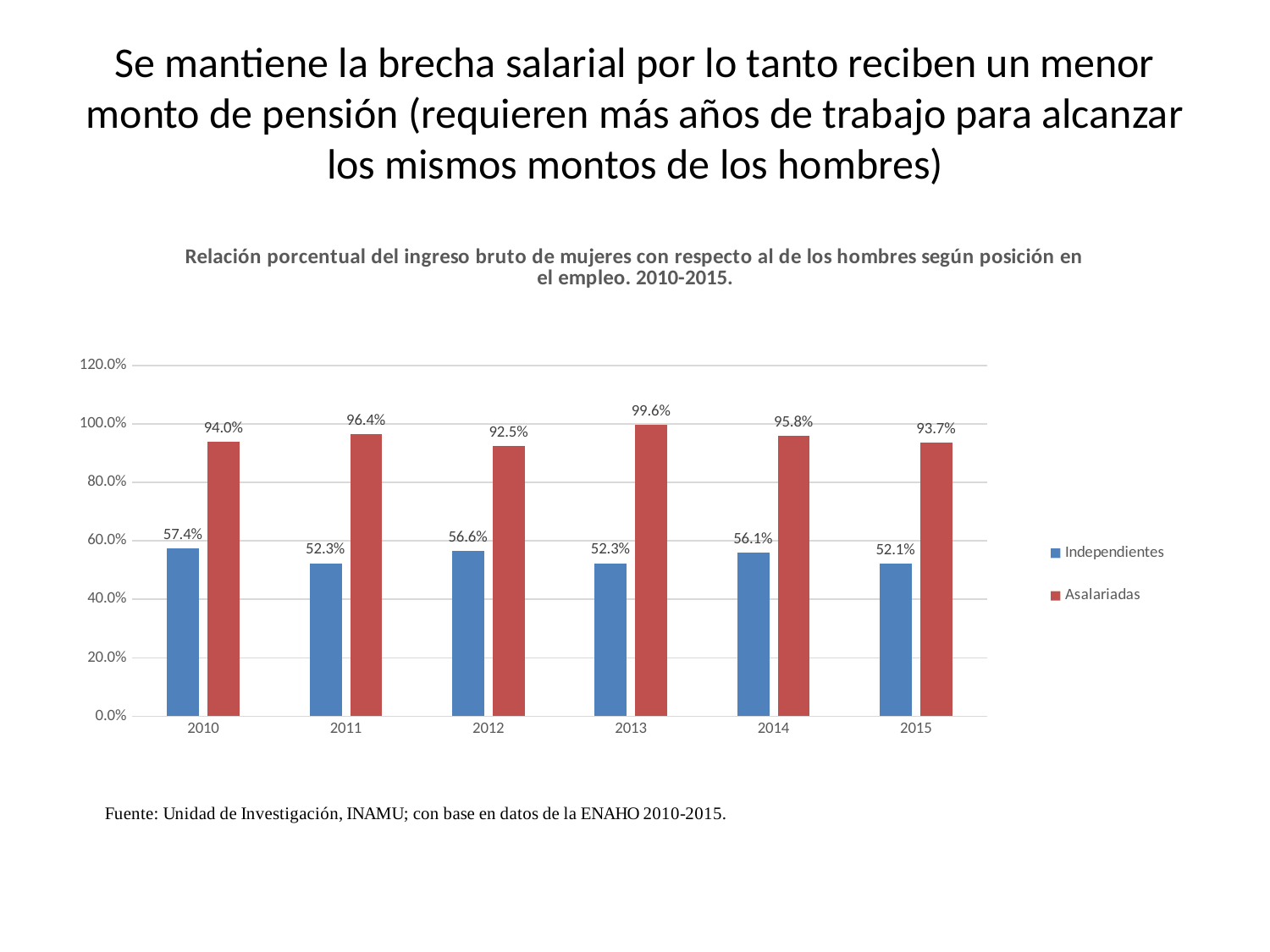
What is the difference between the Asalariadas and Independientes values in 2014? 39.7% Which is larger: the Asalariadas value in 2011 or in 2015? 2011 Which series is shown in red in the legend? Asalariadas What is the value for Independientes in 2010? 57.4% In which year is the Asalariadas value highest? 2013 What is the value for Asalariadas in 2012? 92.5% In which year is the Independientes value lowest? 2015 What kind of chart is shown on the slide? Bar chart What is the value for Asalariadas in 2013? 99.6% How many years are shown on the x axis? 6 How many series does the legend list? 2 Is the value for Independientes in 2012 greater or less than 60.0%? less